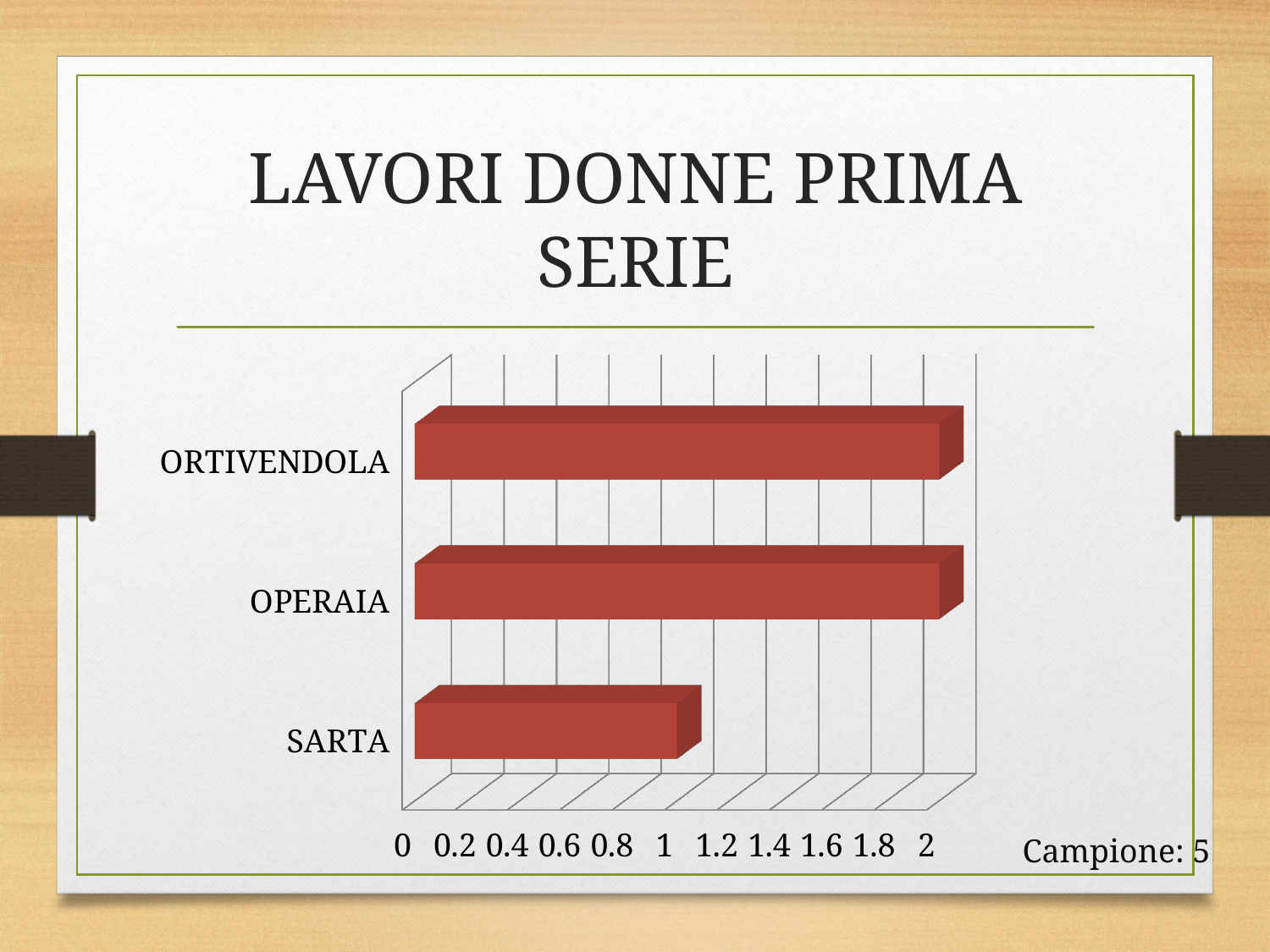
How many categories are shown in the chart? 3 Is the value for ORTIVENDOLA greater or less than 1.6? greater What is the highest value shown on the horizontal axis of the chart? 2 Is the value for SARTA greater or less than 1.4? less Which category has the lowest value in the chart? SARTA Is the value for OPERAIA greater or less than 1.2? greater What kind of chart is shown on the slide? bar chart Which is larger, the value for ORTIVENDOLA or the value for SARTA? ORTIVENDOLA What is the title of the slide containing the chart? LAVORI DONNE PRIMA SERIE Which is larger, the value for OPERAIA or the value for SARTA? OPERAIA